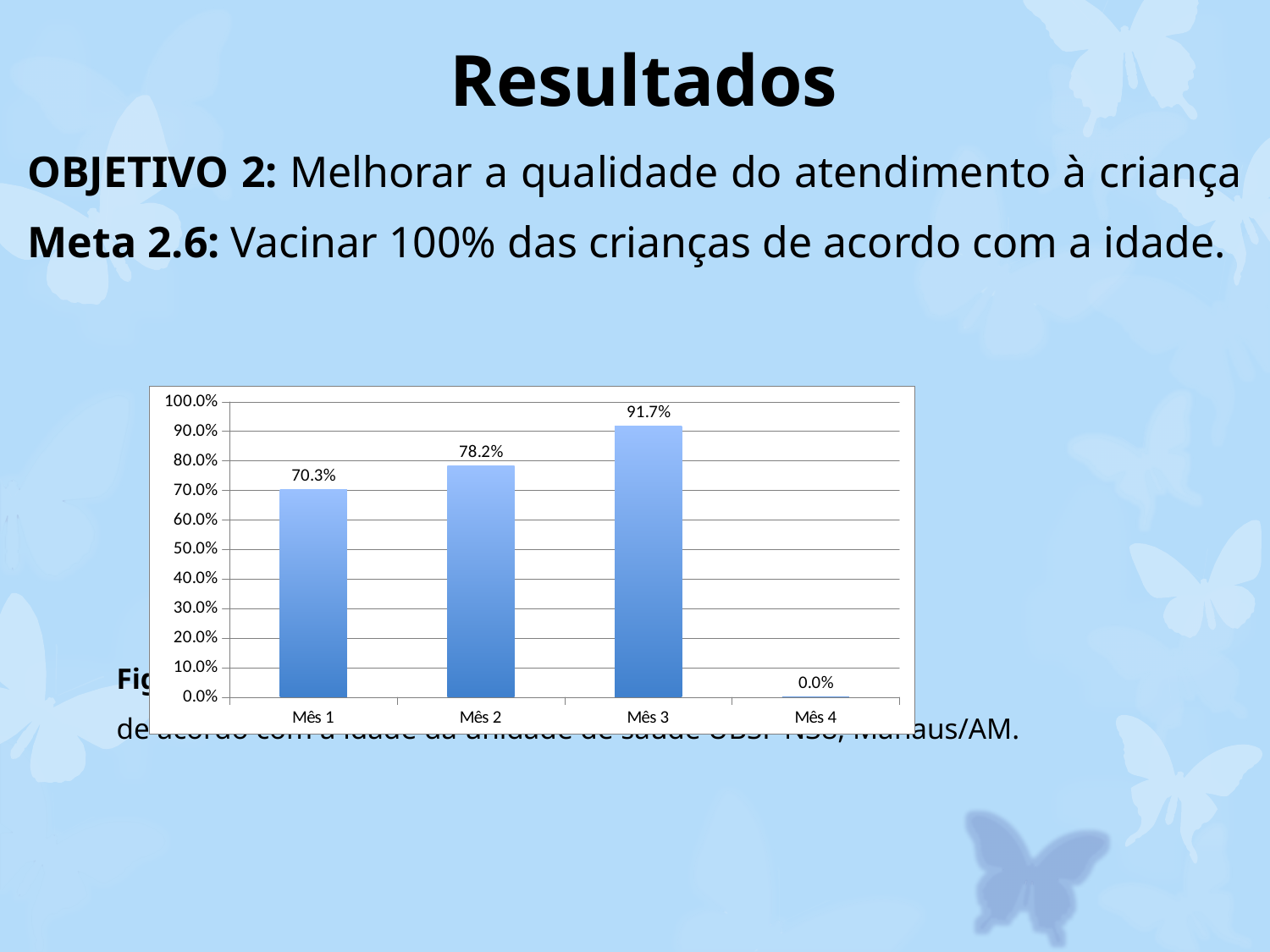
What kind of chart is shown on the slide? bar chart Which month has the lowest value? Mês 4 How many categories are shown on the x axis? 4 What is the difference between the values for Mês 2 and Mês 1? 7.9% What is the value for Mês 3? 91.7% Which is larger, the value for Mês 2 or the value for Mês 3? Mês 3 What is the value for Mês 2? 78.2% What is the value for Mês 1? 70.3% What is the difference between the values for Mês 3 and Mês 1? 21.4% What is the value for Mês 4? 0.0% Which month has the highest value? Mês 3 Is the value for Mês 3 greater or less than 90.0%? greater